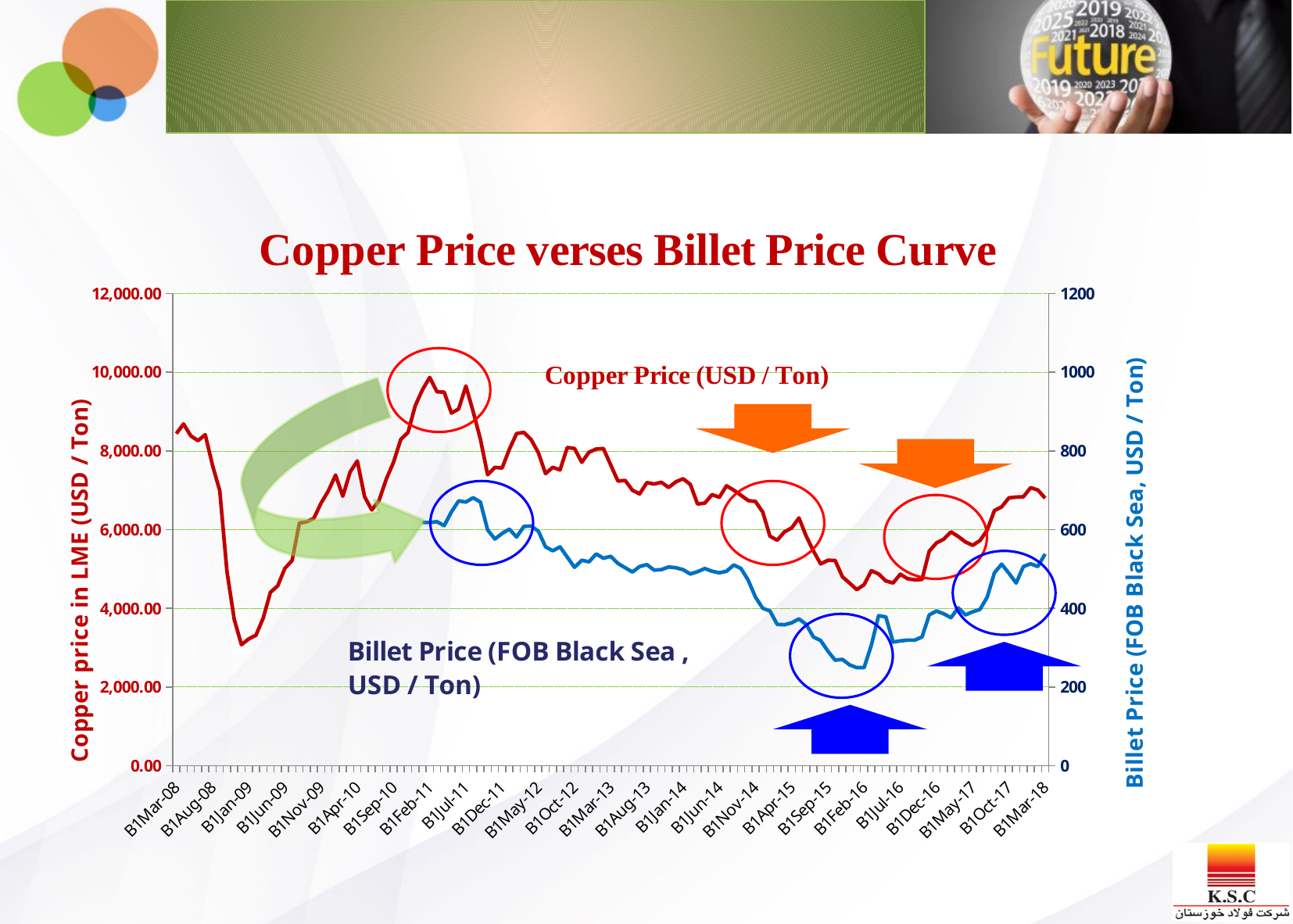
Is the Copper Price at B1Feb-11 greater or less than 8,000.00? greater Is the Billet Price at B1Jul-11 greater or less than 600? greater Is the Copper Price at B1Mar-08 greater or less than 8,000.00? greater How many data series are plotted on the chart? 2 What is the title of the left vertical axis? Copper price in LME (USD / Ton) What is the title of the chart? Copper Price verses Billet Price Curve Does the Copper Price rise or fall between B1Mar-08 and B1Jan-09? fall What kind of chart is shown on the slide? Line chart Around which date does the Copper Price reach its lowest point? B1Jan-09 Does the Billet Price rise or fall between B1Feb-16 and B1Oct-17? rise